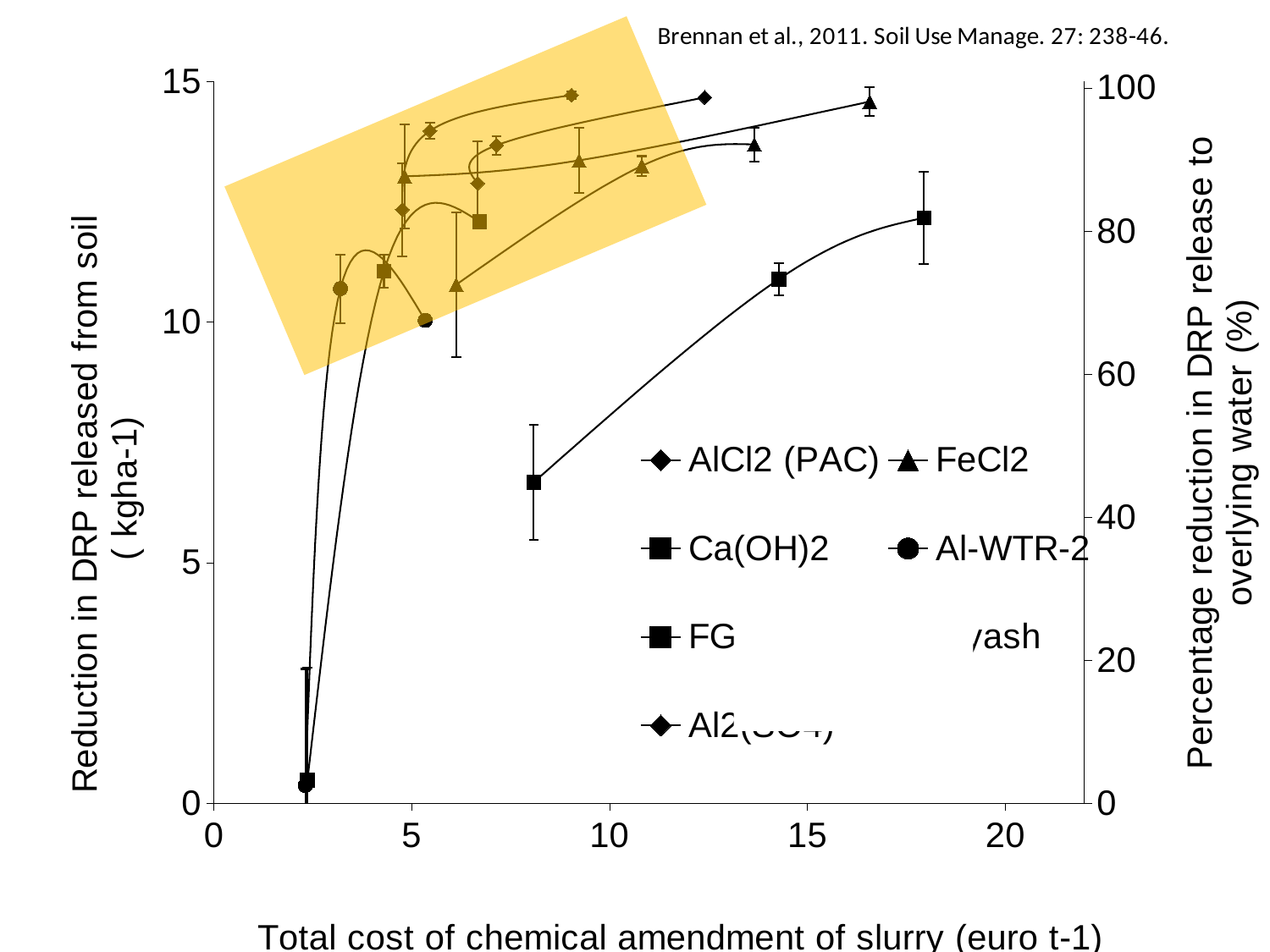
Is the value for the lowest Al-WTR-2 (circle) point greater or less than 5 on the left axis? less What is the highest tick value shown on the right-hand axis? 100 Which is larger on the left axis: the rightmost FeCl2 (triangle) point or the rightmost square-marker point at about 18 euro t-1? FeCl2 (triangle) point What kind of chart is shown on the slide? Scatter chart with lines and error bars What is the title of the x axis? Total cost of chemical amendment of slurry (euro t-1) Is the value for the rightmost FeCl2 (triangle) point greater or less than 10 on the left axis? greater Is the value for the square-marker point at a cost of about 18 euro t-1 greater or less than 10 on the left axis? greater How many series does the legend list? 7 Do the square-marker points between costs of about 8 and 18 euro t-1 rise or fall as cost increases? rise